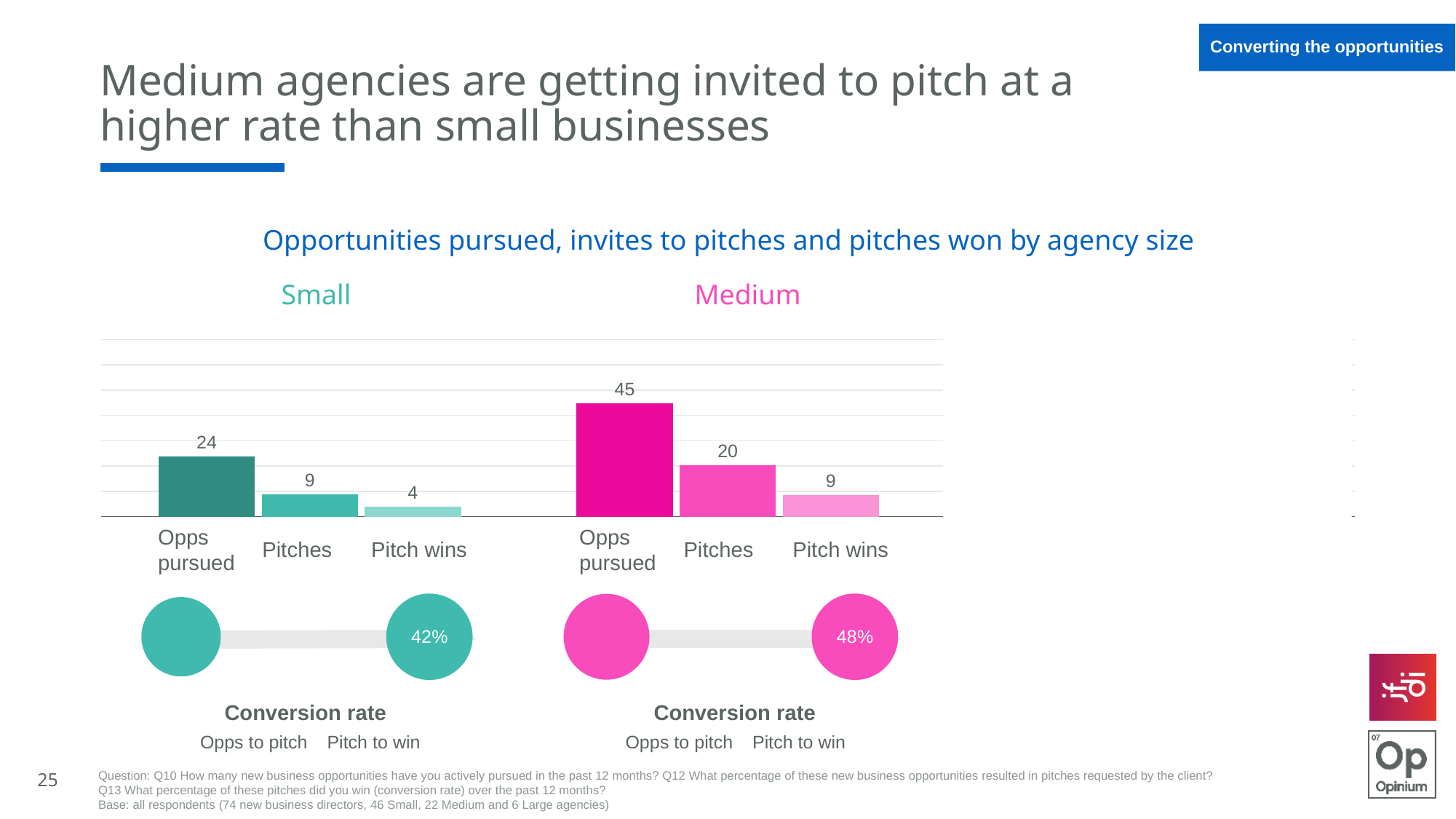
Which is larger: Pitch wins for Medium agencies or Pitches for Small agencies? They are equal (9) How many bars are plotted in the chart in total across Small and Medium? 6 What is the value for Pitch wins for Small agencies? 4 Which category has the highest value for Medium agencies? Opps pursued What type of chart is used to show opportunities pursued, pitches and pitch wins? Bar chart What is the difference between Opps pursued for Medium agencies and Opps pursued for Small agencies? 21 What is the value for Pitches for Medium agencies? 20 What is the Pitch to win conversion rate shown for Small agencies? 42% What is the value for Opps pursued for Medium agencies? 45 What is the value for Opps pursued for Small agencies? 24 What is the Pitch to win conversion rate shown for Medium agencies? 48% Which category has the lowest value for Small agencies? Pitch wins